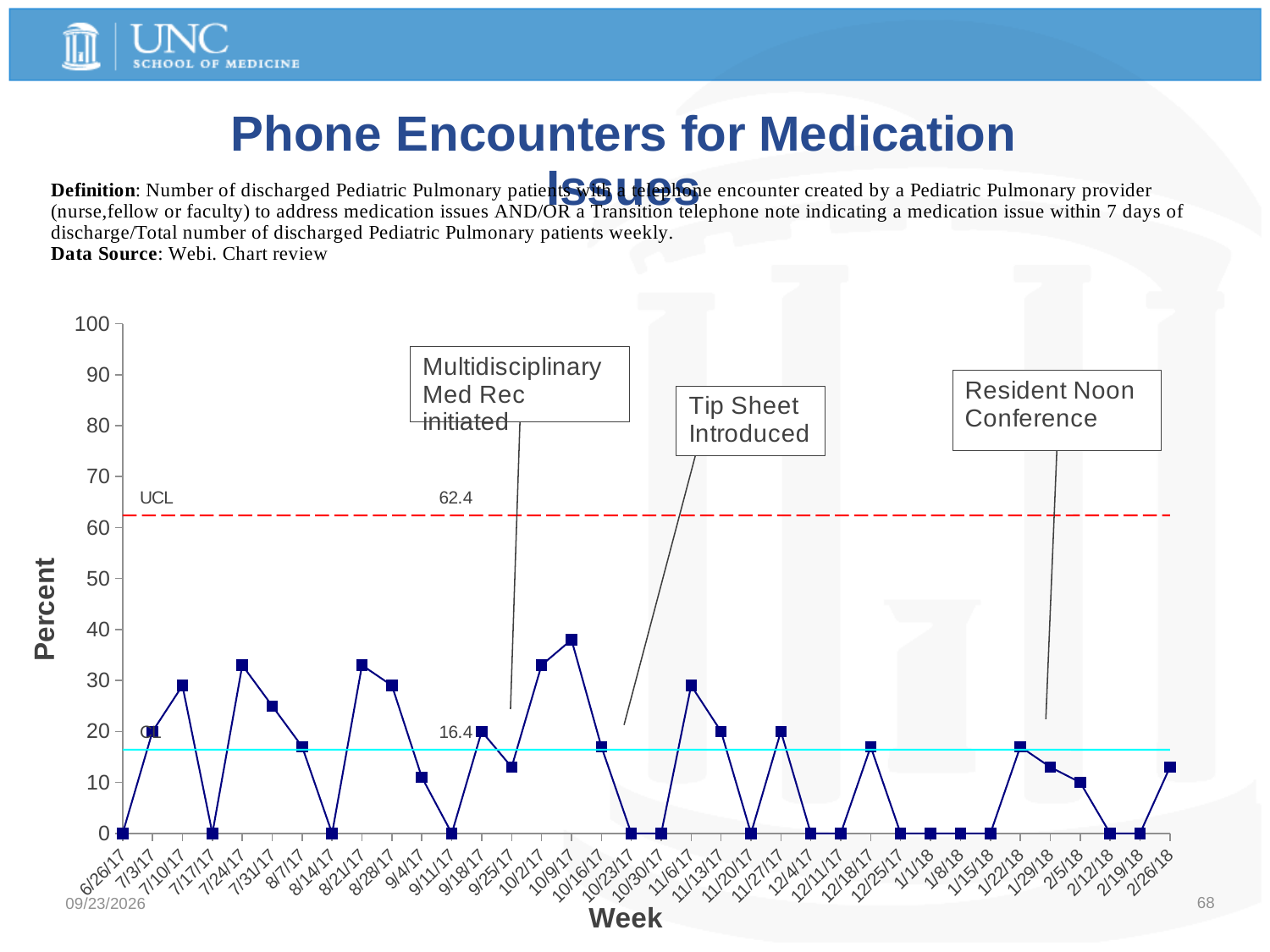
Is the value for the week of 10/9/17 greater or less than 30? greater What is the percent value for the week of 7/17/17? 0 What type of chart is shown on the slide? line chart Which week has the highest percent value on the chart? 10/9/17 Is the value for the week of 8/21/17 greater or less than 30? greater What is the percent value for the week of 1/8/18? 0 Is the value for the week of 1/29/18 greater or less than 20? less What is the UCL value shown on the chart? 62.4 How many weeks are plotted on the x axis of the chart? 36 Which week has the larger value, 10/2/17 or 10/9/17? 10/9/17 What is the CL (center line) value shown on the chart? 16.4 What is the label of the y axis of the chart? Percent